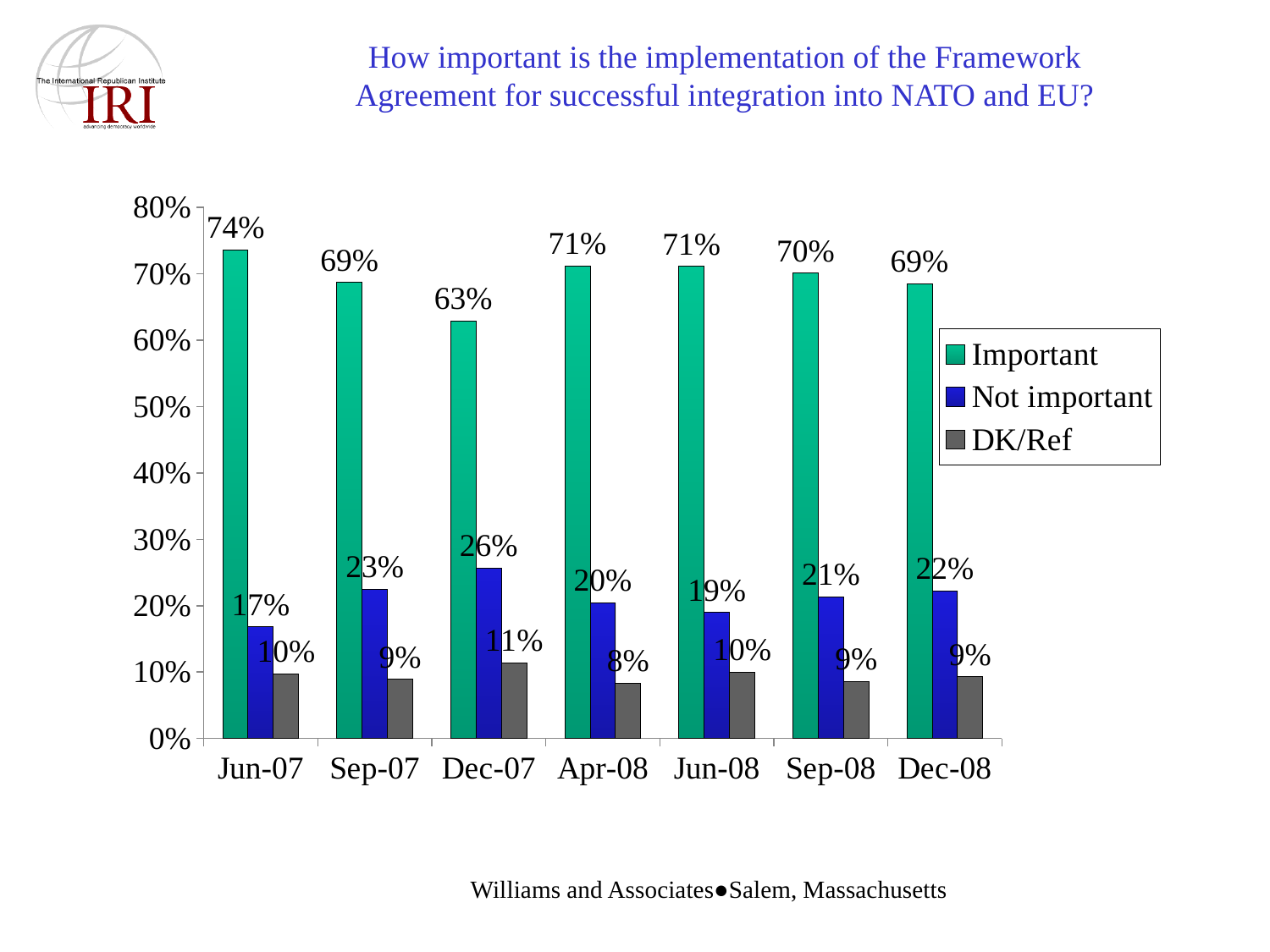
What percentage said 'Important' in Jun-07? 74% Which is larger: the 'Not important' value in Sep-07 or in Jun-08? Sep-07 In which survey period was the 'Important' share lowest? Dec-07 How many survey periods are shown on the x axis? 7 In which survey period was the 'Not important' share highest? Dec-07 What kind of chart is shown on the slide? Bar chart What is the difference between the 'Important' values for Jun-07 and Dec-07? 11 percentage points What is the DK/Ref value for Apr-08? 8% What percentage said 'Not important' in Dec-07? 26% Which series is shown in blue in the legend? Not important Did the 'Not important' share rise or fall from Jun-07 to Dec-07? Rise How many series does the legend list? 3